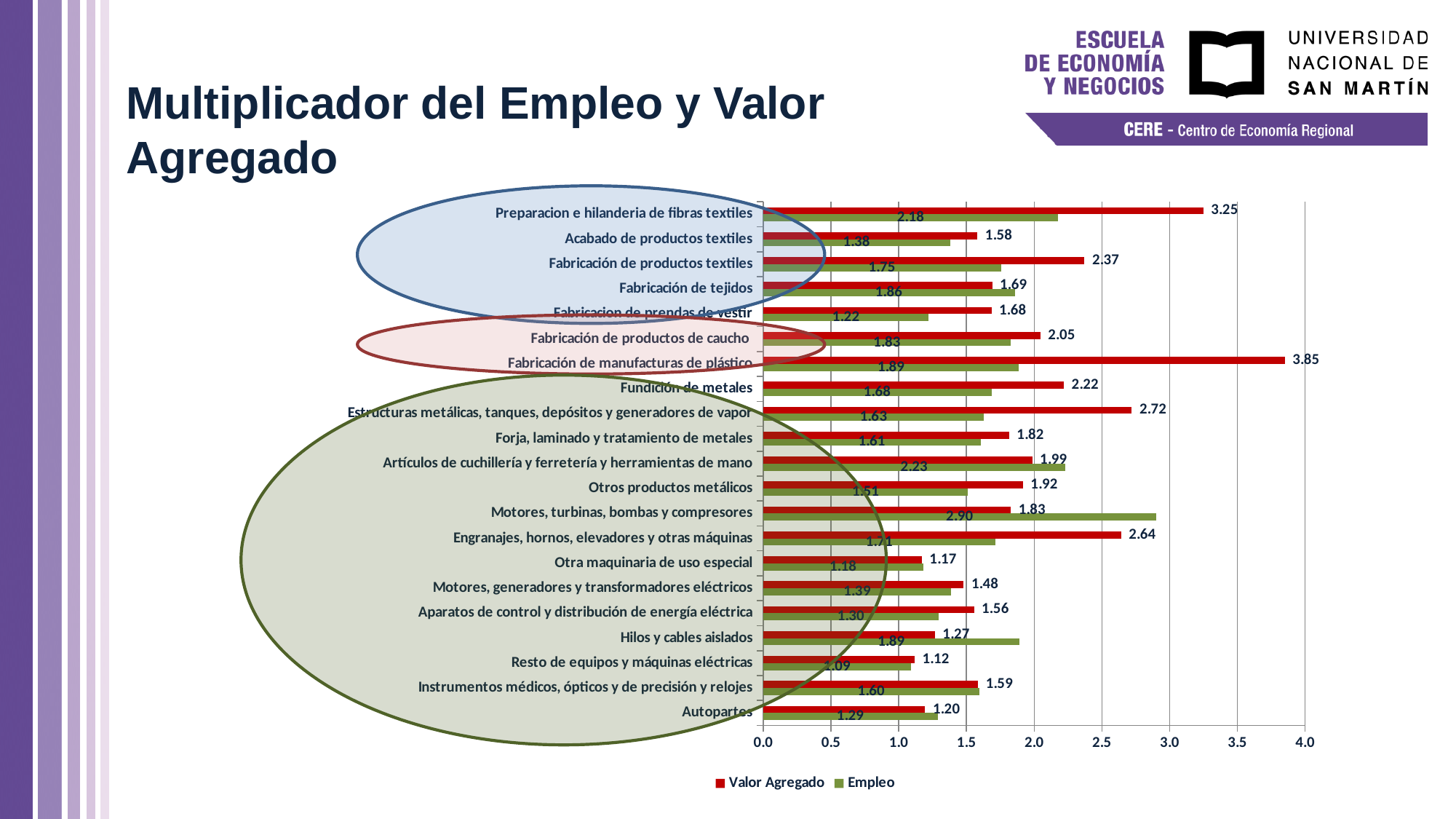
How many series does the legend list? 2 What is the Empleo value for Hilos y cables aislados? 1.89 What is the Valor Agregado value for Preparacion e hilanderia de fibras textiles? 3.25 Which category has the lowest Empleo value? Resto de equipos y máquinas eléctricas Which category has the highest Valor Agregado value? Fabricación de manufacturas de plástico What is the Empleo value for Motores, turbinas, bombas y compresores? 2.90 What kind of chart is shown on the slide? Bar chart How many categories are shown on the chart? 21 What is the difference between the Valor Agregado and Empleo values for Fabricación de manufacturas de plástico? 1.96 For Hilos y cables aislados, which series has the larger value, Valor Agregado or Empleo? Empleo What colour represents the Valor Agregado series? Red What is the Valor Agregado value for Fabricación de manufacturas de plástico? 3.85